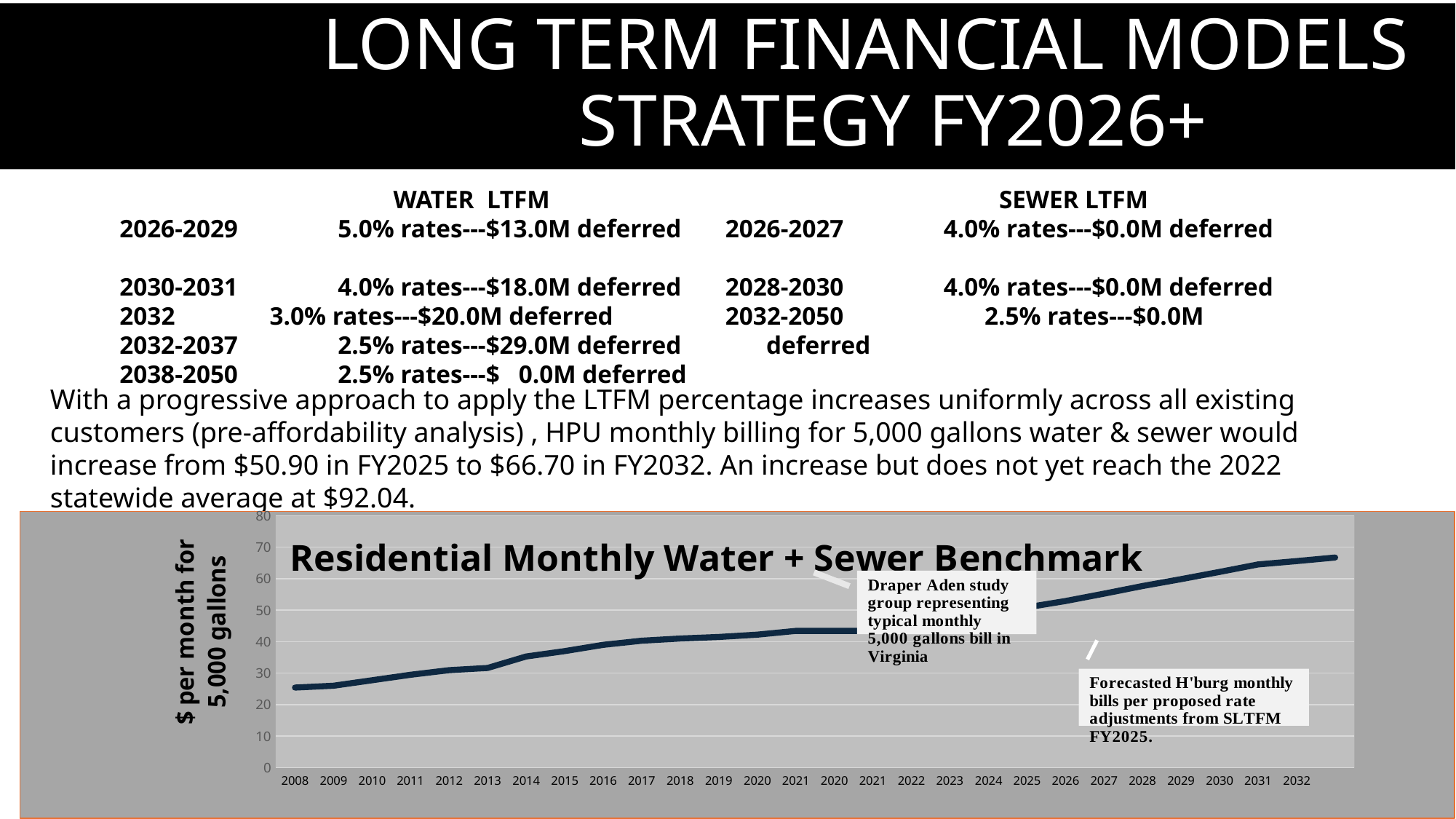
What is the title of the chart? Residential Monthly Water + Sewer Benchmark Which is larger, the value for 2032 or the value for 2008? 2032 What kind of chart is shown on the slide? line chart Is the value for 2016 greater or less than 30? greater Which year has the lowest value in the chart? 2008 How many year labels are shown along the x axis of the chart? 27 Is the value for 2032 greater or less than 60? greater Is the value for 2008 greater or less than 30? less Which year has the highest value in the chart? 2032 What is the label on the vertical axis of the chart? $ per month for 5,000 gallons Do the values in the chart rise or fall from 2008 to 2032? rise